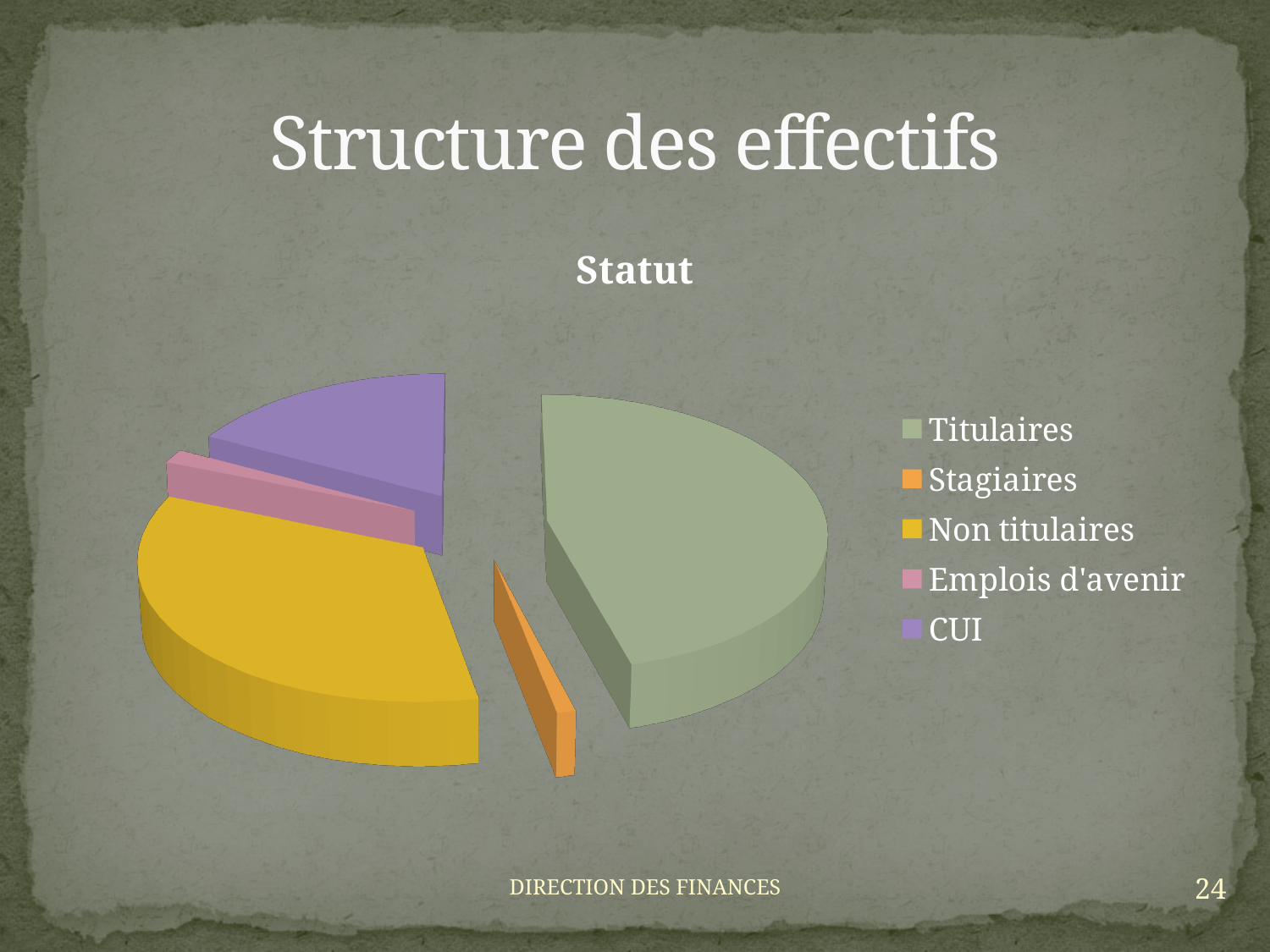
Which category has the largest slice of the pie? Titulaires Which category is shown in yellow? Non titulaires How many categories does the pie chart show? 5 Which slice is larger, Titulaires or Non titulaires? Titulaires Which category has the smallest slice of the pie? Stagiaires Which slice is larger, Non titulaires or CUI? Non titulaires What kind of chart is shown on the slide? Pie chart What is the title of the chart? Statut Which slice is larger, CUI or Emplois d'avenir? CUI Which category is listed last in the legend? CUI